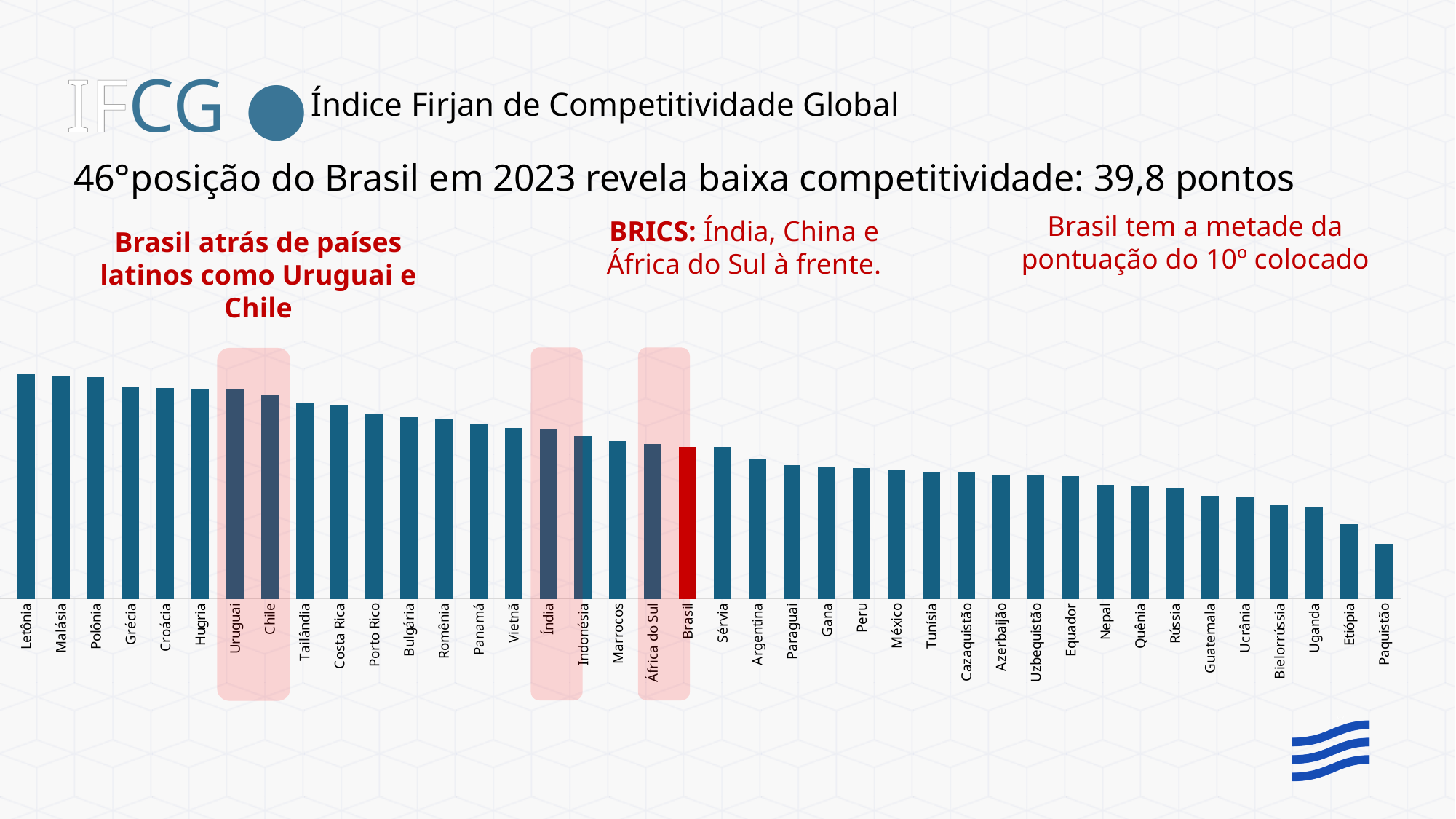
Which country has the lowest bar in the chart? Paquistão Which country has the highest bar in the chart? Letônia Which has the taller bar, Tailândia or Argentina? Tailândia Do the bar values rise or fall from left to right along the x axis? fall Which has the taller bar, Uruguai or Brasil? Uruguai Which has the taller bar, Etiópia or Rússia? Rússia Which country's bar is coloured red in the chart? Brasil What kind of chart is shown on the slide? bar chart Which country appears immediately to the left of Brasil in the chart? África do Sul How many countries are shown in the chart? 40